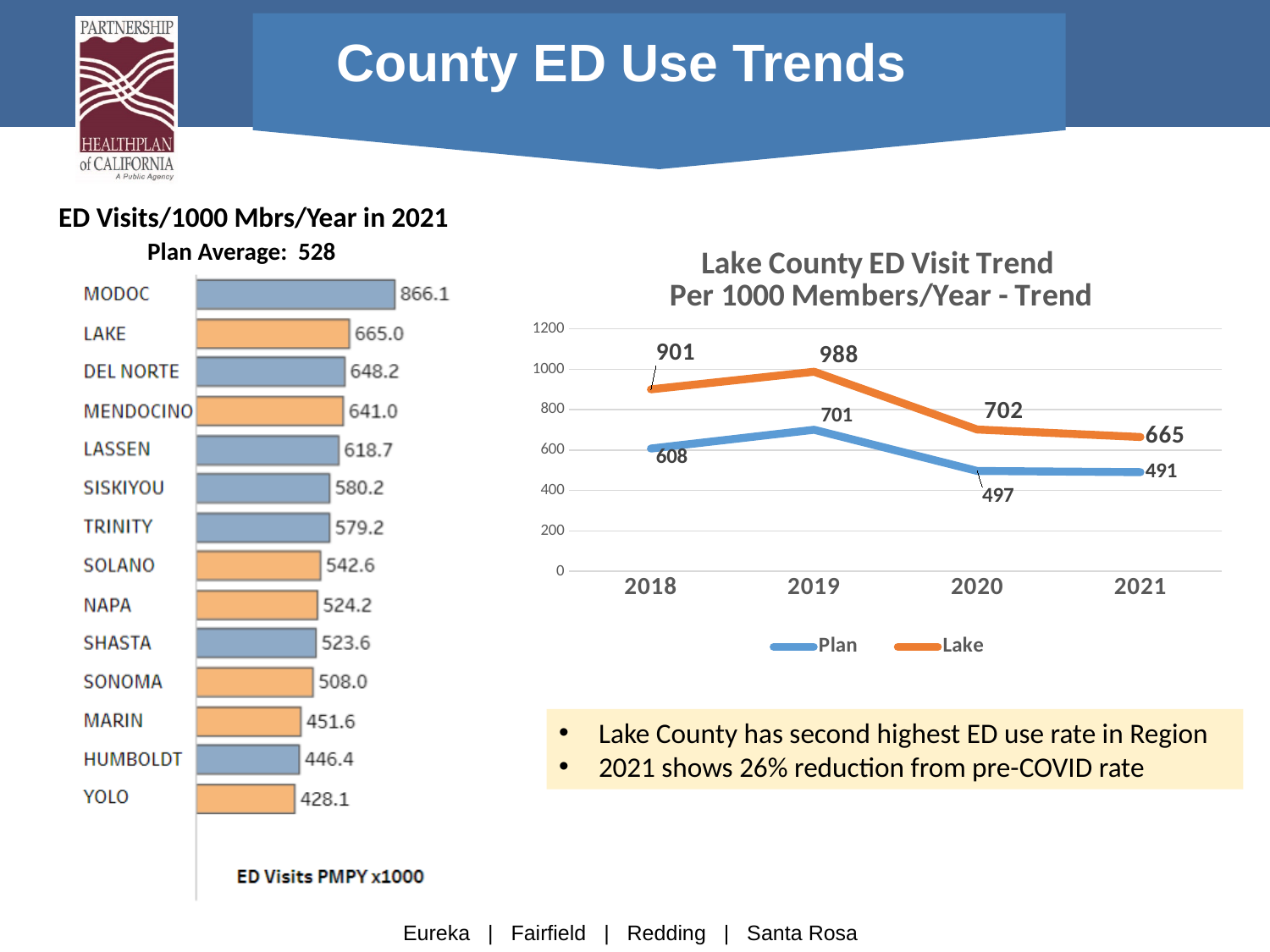
In the Lake County ED Visit Trend chart, does the Lake series rise or fall from 2019 to 2021? Fall In the Lake County ED Visit Trend chart, how many series does the legend list? 2 In the ED Visits/1000 Mbrs/Year in 2021 bar chart, which county has the lowest value? YOLO In the Lake County ED Visit Trend chart, what is the difference between the Lake and Plan values in 2020? 205 In the Lake County ED Visit Trend chart, what is the Lake value for 2019? 988 In the ED Visits/1000 Mbrs/Year in 2021 bar chart, what is the value for LAKE? 665.0 In the ED Visits/1000 Mbrs/Year in 2021 bar chart, which is larger, SOLANO or NAPA? SOLANO In the Lake County ED Visit Trend chart, what is the Plan value for 2021? 491 In the ED Visits/1000 Mbrs/Year in 2021 bar chart, which county has the highest value? MODOC In the ED Visits/1000 Mbrs/Year in 2021 bar chart, how many counties are shown? 14 What kind of chart is the ED Visits/1000 Mbrs/Year in 2021 chart? Bar chart In the ED Visits/1000 Mbrs/Year in 2021 bar chart, what is the difference between MODOC and LAKE? 201.1